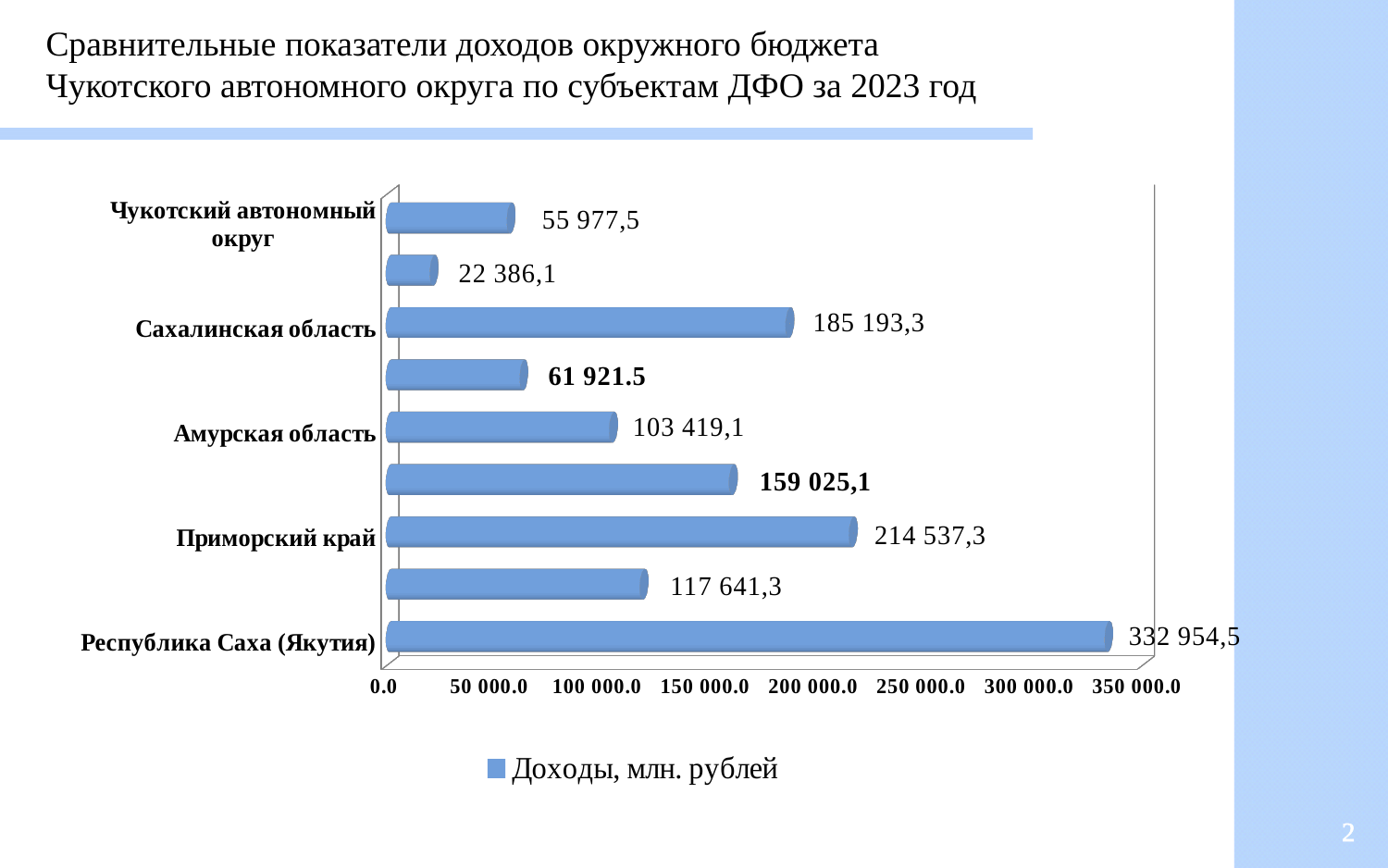
What is the value for Республика Саха (Якутия)? 332 954,5 What is the value for Сахалинская область? 185 193,3 What is the value for Чукотский автономный округ? 55 977,5 What is the value for Приморский край? 214 537,3 What is the smallest value printed on the chart? 22 386,1 What kind of chart is shown on the slide? bar chart Which is larger, the value for Сахалинская область or for Приморский край? Приморский край What is the difference between the values for Приморский край and Амурская область? 111 118,2 How many bars are plotted on the chart? 9 Is the value for Амурская область greater or less than 100 000.0? greater How many series does the legend list? 1 Which labelled category has the highest value? Республика Саха (Якутия)